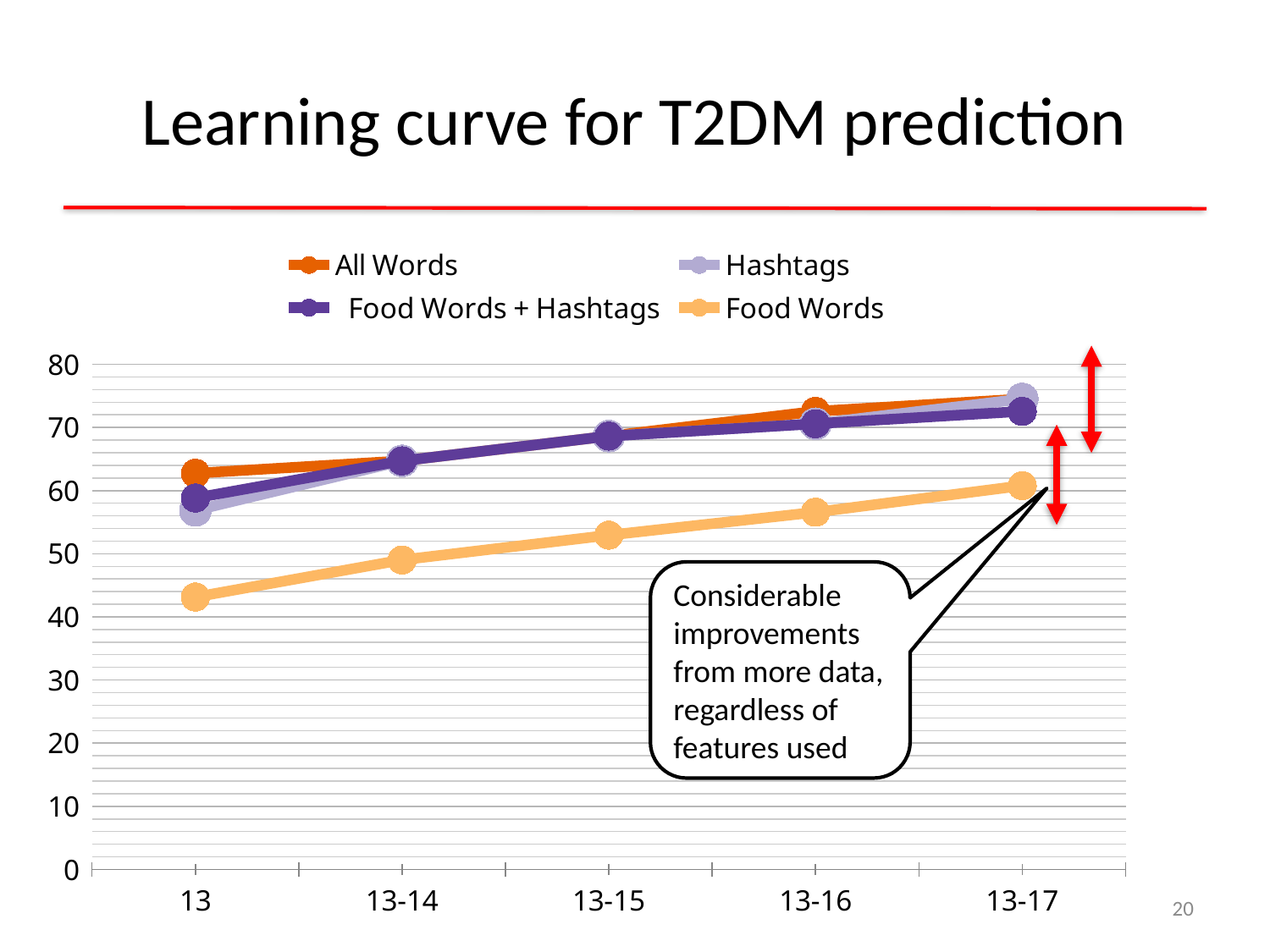
What is the title of the chart? Learning curve for T2DM prediction Is the value for All Words at 13-17 greater or less than 70? greater Is the value for Food Words at 13-16 greater or less than 50? greater Is the value for Hashtags at 13 greater or less than 60? less Which series has the lowest value at 13-17? Food Words Do the values for Food Words rise or fall from 13 to 13-17? rise What kind of chart is shown on the slide? line chart How many categories are shown along the x axis? 5 Which series has the highest value at 13? All Words At 13-17, which is larger: Hashtags or Food Words? Hashtags How many series does the legend list? 4